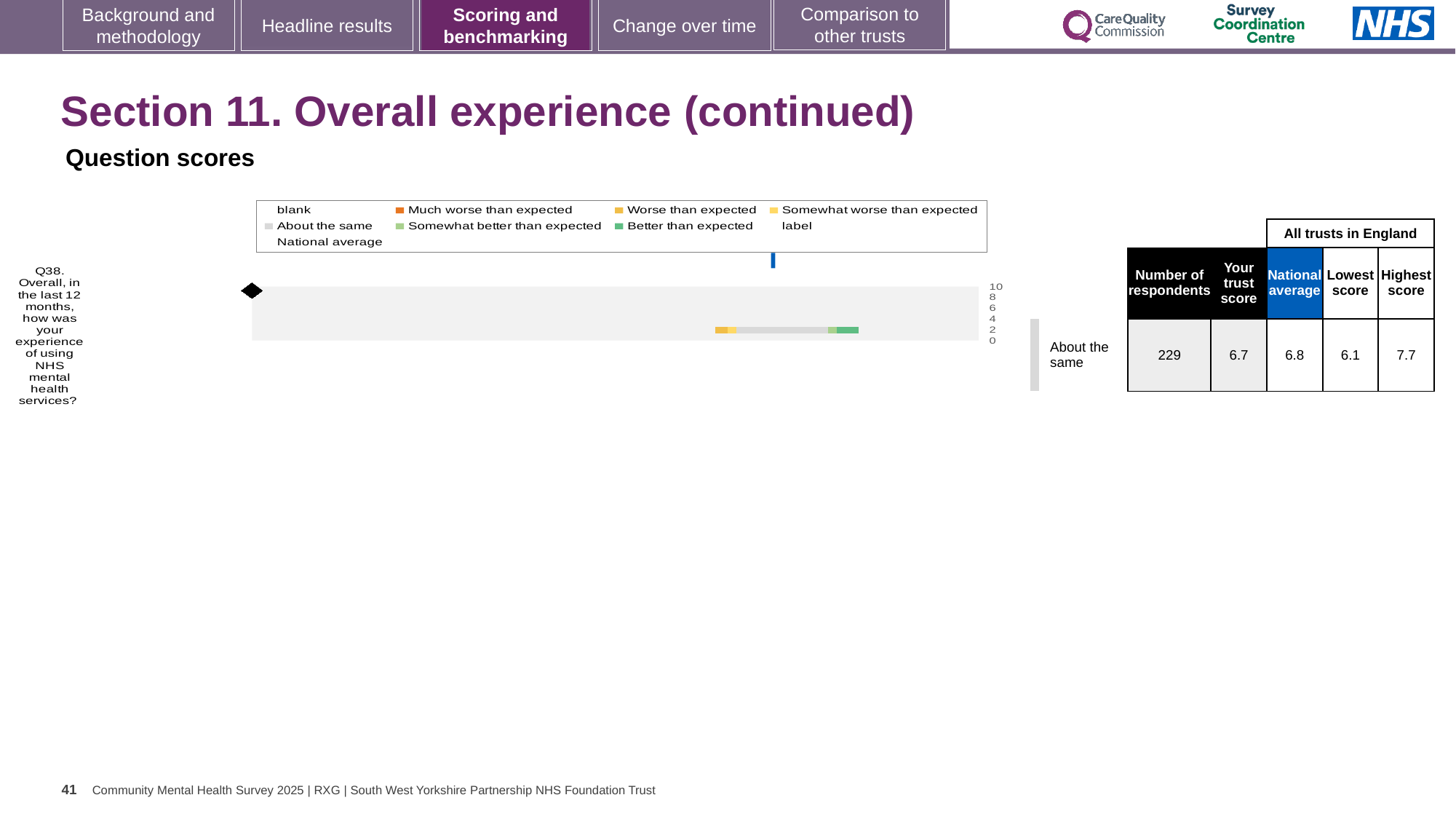
Which question is plotted in the chart? Q38. Overall, in the last 12 months, how was your experience of using NHS mental health services? In the table beside the chart, what is the lowest score among all trusts in England for Q38? 6.1 What benchmark category label is shown next to the chart for Q38? About the same In the table beside the chart, what is the trust's score for Q38? 6.7 How many questions (categories) are plotted in the chart? 1 Which is larger for Q38, the trust's score or the national average? national average What is the difference between the highest and lowest scores among all trusts in England for Q38? 1.6 In the table beside the chart, what is the highest score among all trusts in England for Q38? 7.7 In the table beside the chart, what is the national average for Q38? 6.8 What kind of chart is used to show the Q38 question score? bar chart In the table beside the chart, what is the number of respondents for Q38? 229 What is the highest value shown on the chart's axis? 10